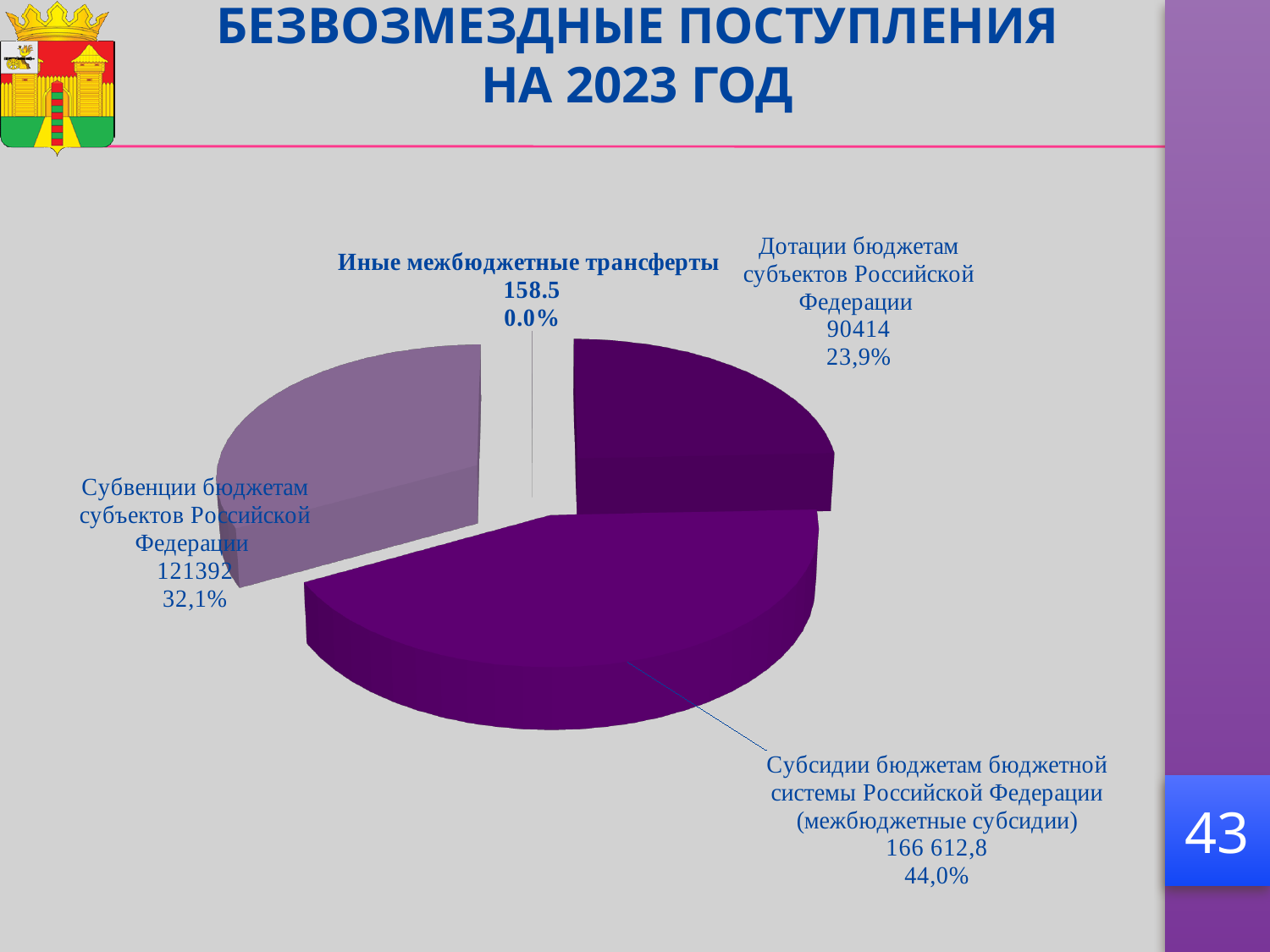
Which category has the largest slice of the pie? Субсидии бюджетам бюджетной системы Российской Федерации (межбюджетные субсидии) What is the value for Иные межбюджетные трансферты? 158.5 What is the value for Субсидии бюджетам бюджетной системы Российской Федерации (межбюджетные субсидии)? 166 612,8 Which is larger: Субвенции бюджетам субъектов Российской Федерации or Дотации бюджетам субъектов Российской Федерации? Субвенции бюджетам субъектов Российской Федерации What share of the pie does Дотации бюджетам субъектов Российской Федерации represent? 23,9% What share of the pie does Субвенции бюджетам субъектов Российской Федерации represent? 32,1% Which category has the smallest slice of the pie? Иные межбюджетные трансферты What is the title of the slide with the pie chart? БЕЗВОЗМЕЗДНЫЕ ПОСТУПЛЕНИЯ НА 2023 ГОД How many slices does the pie chart have? 4 What is the value for Субвенции бюджетам субъектов Российской Федерации? 121392 What is the value for Дотации бюджетам субъектов Российской Федерации? 90414 What kind of chart is shown on the slide? pie chart